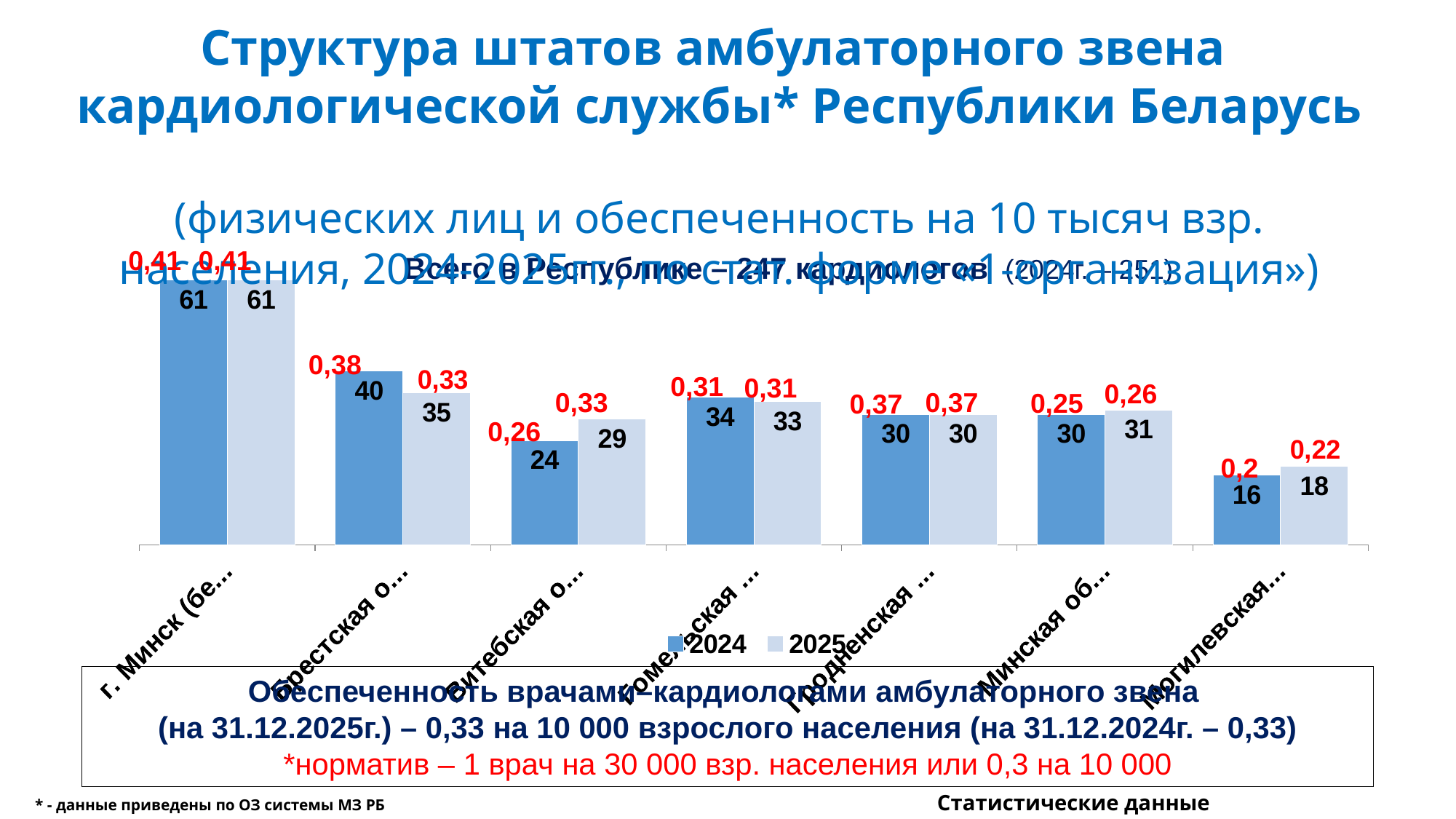
What are the two series names listed in the legend? 2024 and 2025 What is the 2024 value (black label) for the Брестская bar? 40 What red label (per 10 000 population) is shown above the 2025 bar for Минская область? 0,26 What is the 2025 value (black label) for the Могилевская bar? 18 How many regions (categories) are shown on the x axis of the chart? 7 Which region has the lowest 2025 bar? Могилевская Which region has the highest 2024 bar? г. Минск Which is larger for Витебская: the 2024 value or the 2025 value? 2025 What is the 2025 value (black label) for the Витебская bar? 29 What is the difference between the 2024 and 2025 values for Брестская (40 and 35)? 5 How many series does the chart legend list? 2 What kind of chart is shown on the slide? bar chart